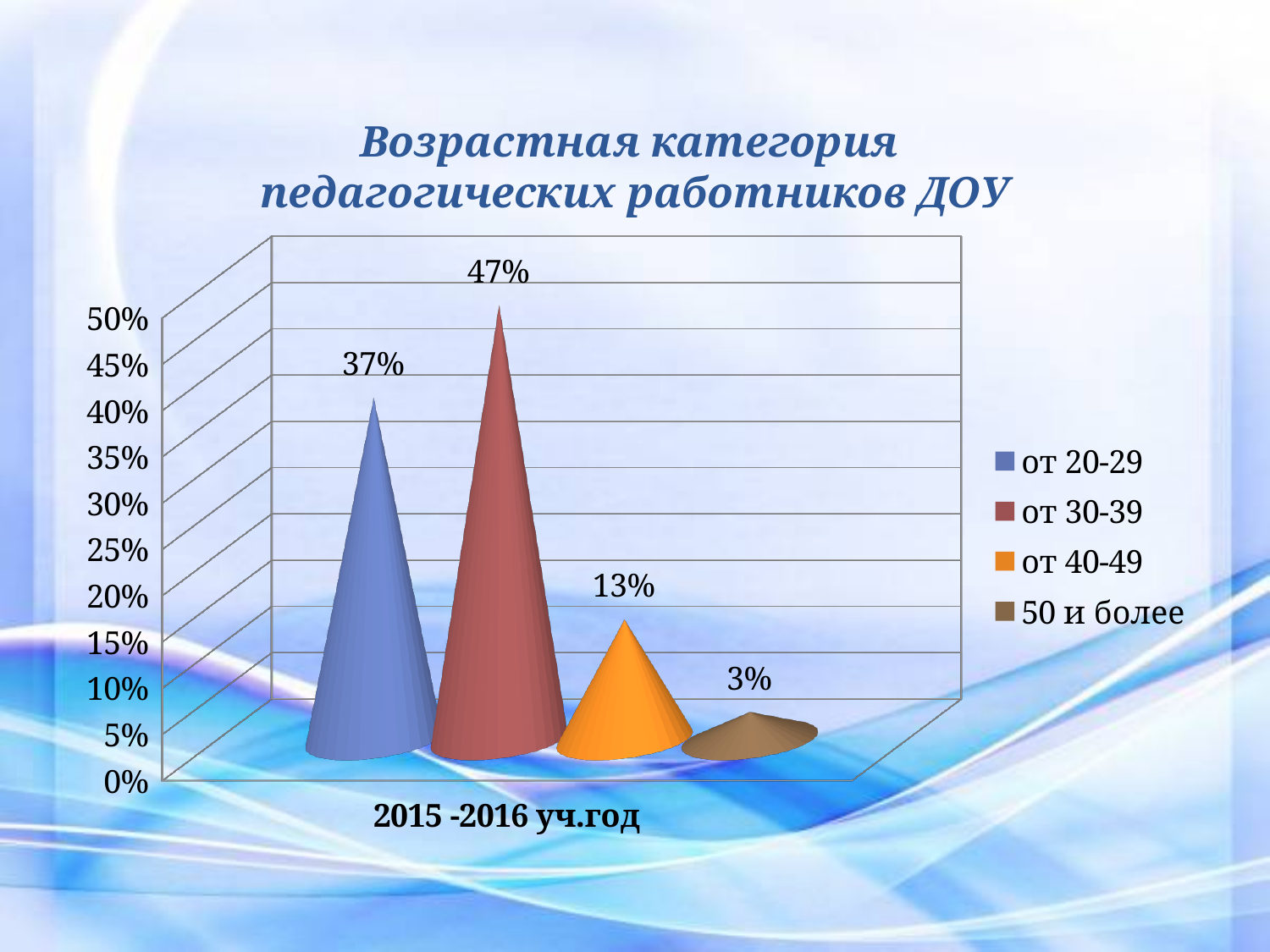
What is the value for the "от 20-29" series? 37% What is the value for the "от 30-39" series? 47% What is the value for the "50 и более" series? 3% Which age category has the lowest value? 50 и более Which age category has the highest value? от 30-39 What colour represents the "от 40-49" series in the legend? Orange What is the difference between the values for "от 30-39" and "от 20-29"? 10% What is the value for the "от 40-49" series? 13% What is the category label shown on the x axis? 2015 -2016 уч.год How many series does the legend list? 4 What kind of chart is shown on the slide? Bar chart Which is larger, the value for "от 40-49" or the value for "50 и более"? от 40-49